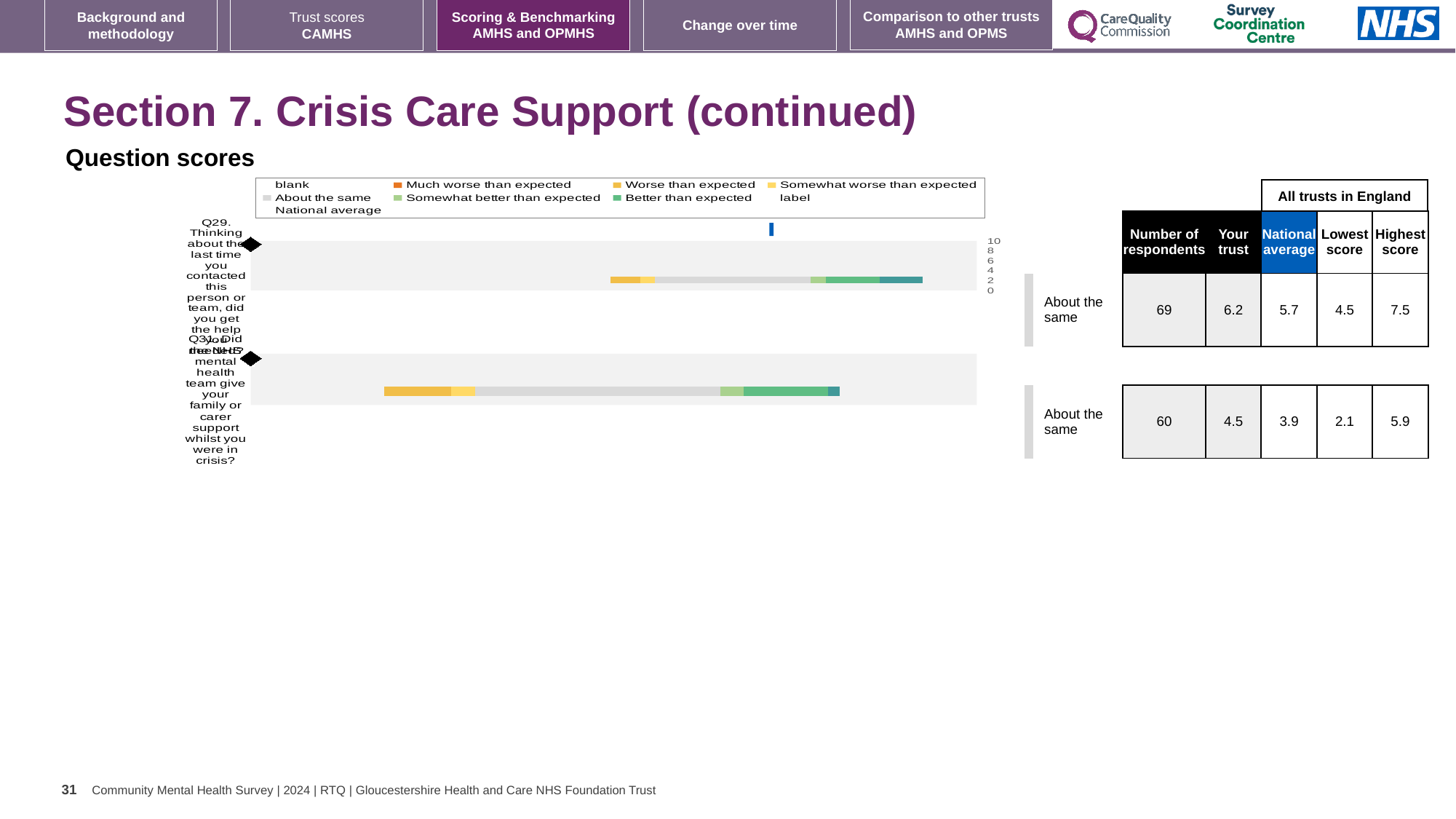
What kind of chart is used to show the question scores? bar chart Which legend entry in the question scores chart is shown in orange? Much worse than expected In the table beside the chart, what is the national average for Q31? 3.9 In the table beside the chart, what is the 'Your trust' score for Q29? 6.2 What is the heading above the question scores chart? Question scores In the table beside the chart, what is the highest score for Q31? 5.9 How many questions (categories) are plotted in the question scores chart? 2 In the table beside the chart, what is the difference between the highest score and the lowest score for Q29? 3.0 How many entries does the legend of the question scores chart list? 9 In the table beside the chart, what is the 'Your trust' score for Q31? 4.5 In the table beside the chart, how many respondents are listed for Q29? 69 Which question has the higher 'Your trust' score in the table beside the chart, Q29 or Q31? Q29